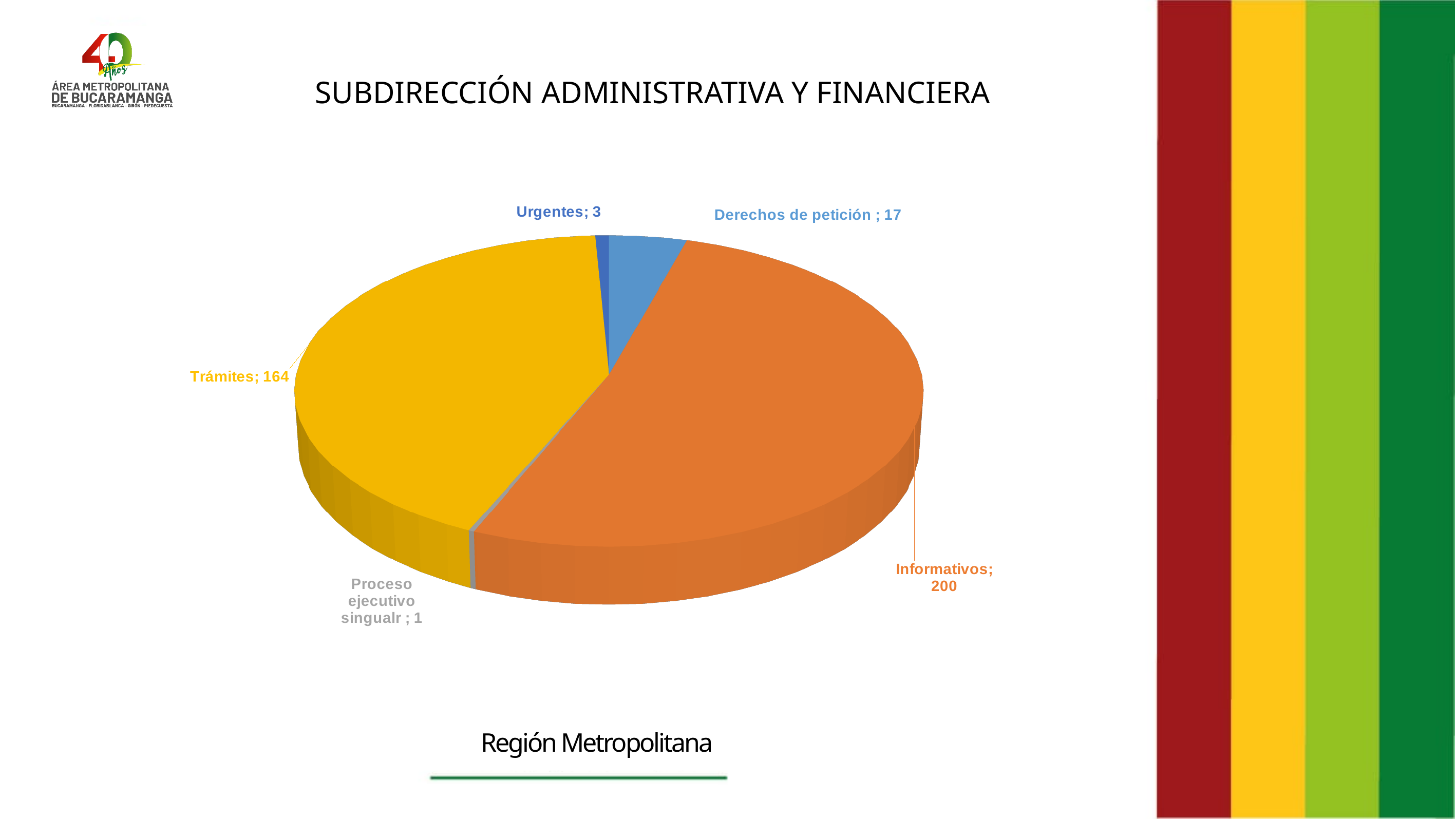
Which category has the largest slice of the pie? Informativos What is the total of all the values shown in the pie chart? 385 What is the value for Urgentes? 3 What is the value for Derechos de petición? 17 What is the value for Informativos? 200 Which category has the smallest slice of the pie? Proceso ejecutivo singualr What is the difference between the values for Informativos and Trámites? 36 What is the value for Trámites? 164 What is the value for Proceso ejecutivo singualr? 1 How many categories are shown in the pie chart? 5 What kind of chart is shown on the slide? pie chart Which is larger, the value for Derechos de petición or the value for Urgentes? Derechos de petición